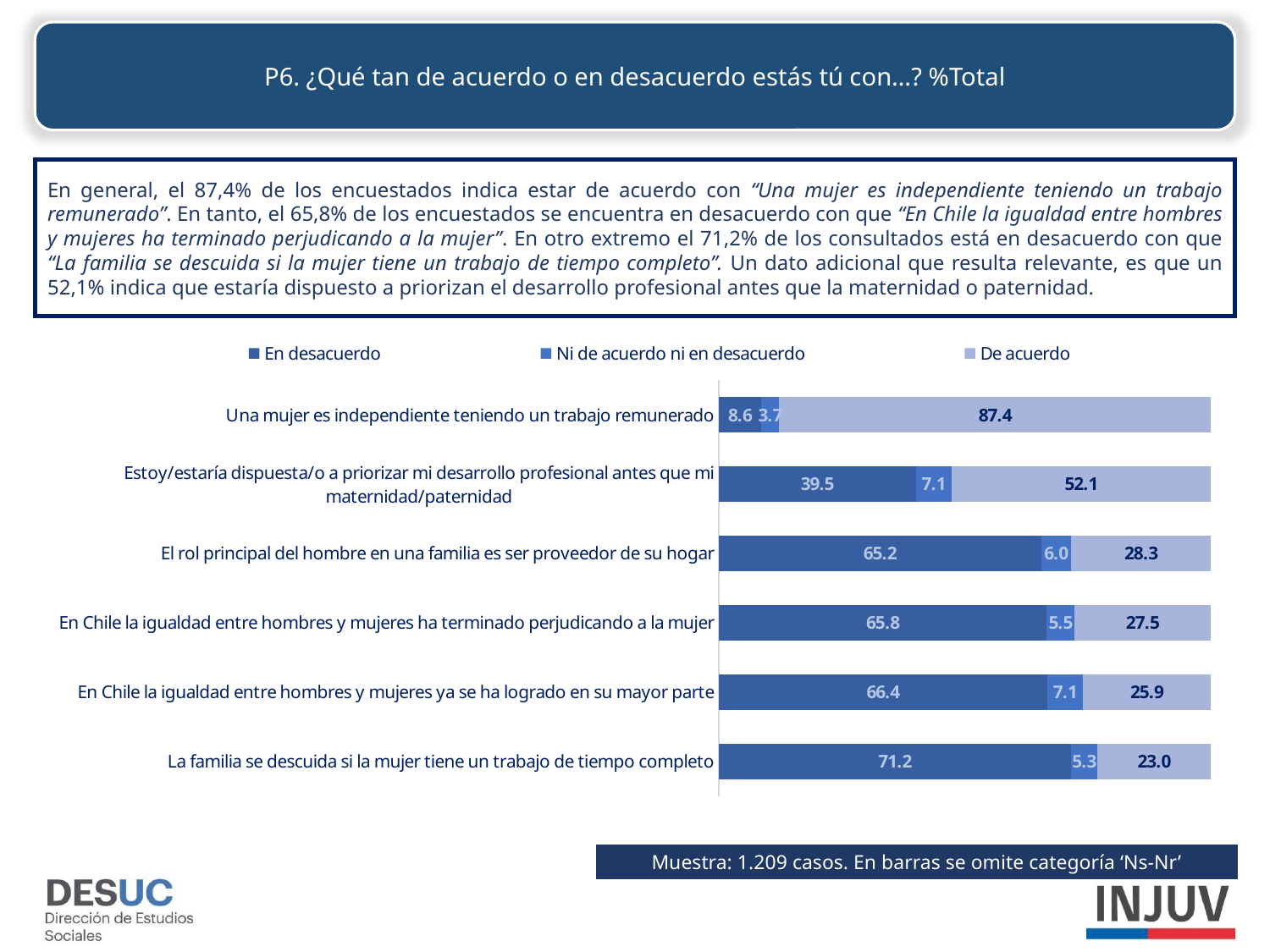
Which is larger: the 'De acuerdo' value for 'El rol principal del hombre en una familia es ser proveedor de su hogar' or for 'En Chile la igualdad entre hombres y mujeres ha terminado perjudicando a la mujer'? El rol principal del hombre en una familia es ser proveedor de su hogar What is the 'Ni de acuerdo ni en desacuerdo' value for 'Estoy/estaría dispuesta/o a priorizar mi desarrollo profesional antes que mi maternidad/paternidad'? 7.1 Which statement has the highest 'En desacuerdo' value? La familia se descuida si la mujer tiene un trabajo de tiempo completo Which legend entry is shown in the lightest shade of blue? De acuerdo What is the 'En desacuerdo' value for 'La familia se descuida si la mujer tiene un trabajo de tiempo completo'? 71.2 How many statements (categories) are plotted in the chart? 6 What kind of chart is shown on the slide? Stacked bar chart How many series does the chart legend list? 3 What is the total of the three plotted values for 'Estoy/estaría dispuesta/o a priorizar mi desarrollo profesional antes que mi maternidad/paternidad'? 98.7 What is the difference between the 'En desacuerdo' values for 'En Chile la igualdad entre hombres y mujeres ya se ha logrado en su mayor parte' and 'El rol principal del hombre en una familia es ser proveedor de su hogar'? 1.2 What is the 'De acuerdo' value for 'Una mujer es independiente teniendo un trabajo remunerado'? 87.4 Which statement has the lowest 'De acuerdo' value? La familia se descuida si la mujer tiene un trabajo de tiempo completo